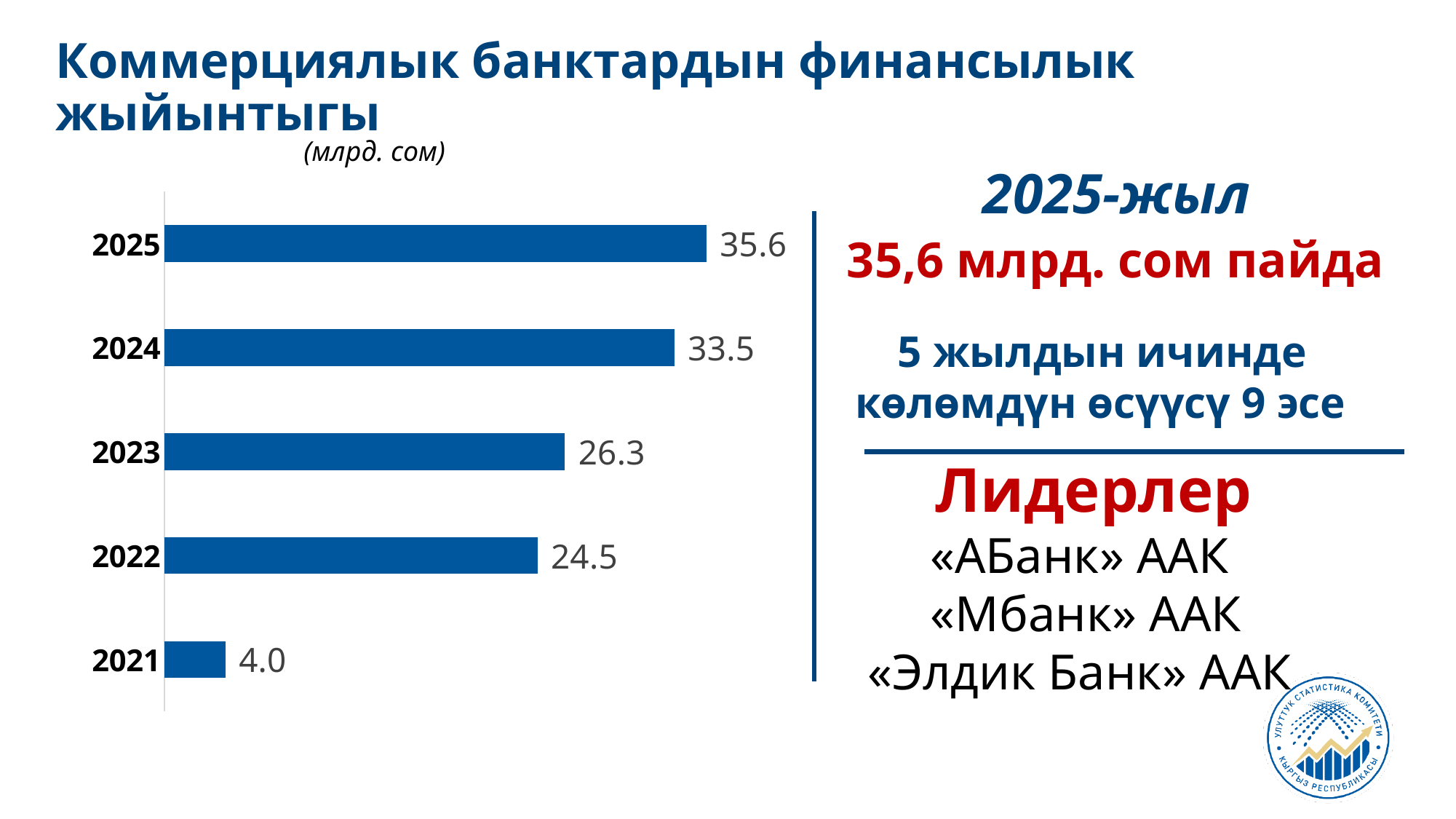
How many years are shown in the chart? 5 Which is larger, the value for 2022 or the value for 2023? 2023 Which year has the lowest value? 2021 What is the difference between the values for 2023 and 2022? 1.8 Which year has the highest value? 2025 What is the difference between the values for 2025 and 2024? 2.1 What is the value for 2021? 4.0 Do the values rise or fall from 2021 to 2025? rise What is the value for 2025? 35.6 What is the value for 2023? 26.3 What kind of chart is shown on the slide? bar chart What unit is given under the chart title? млрд. сом